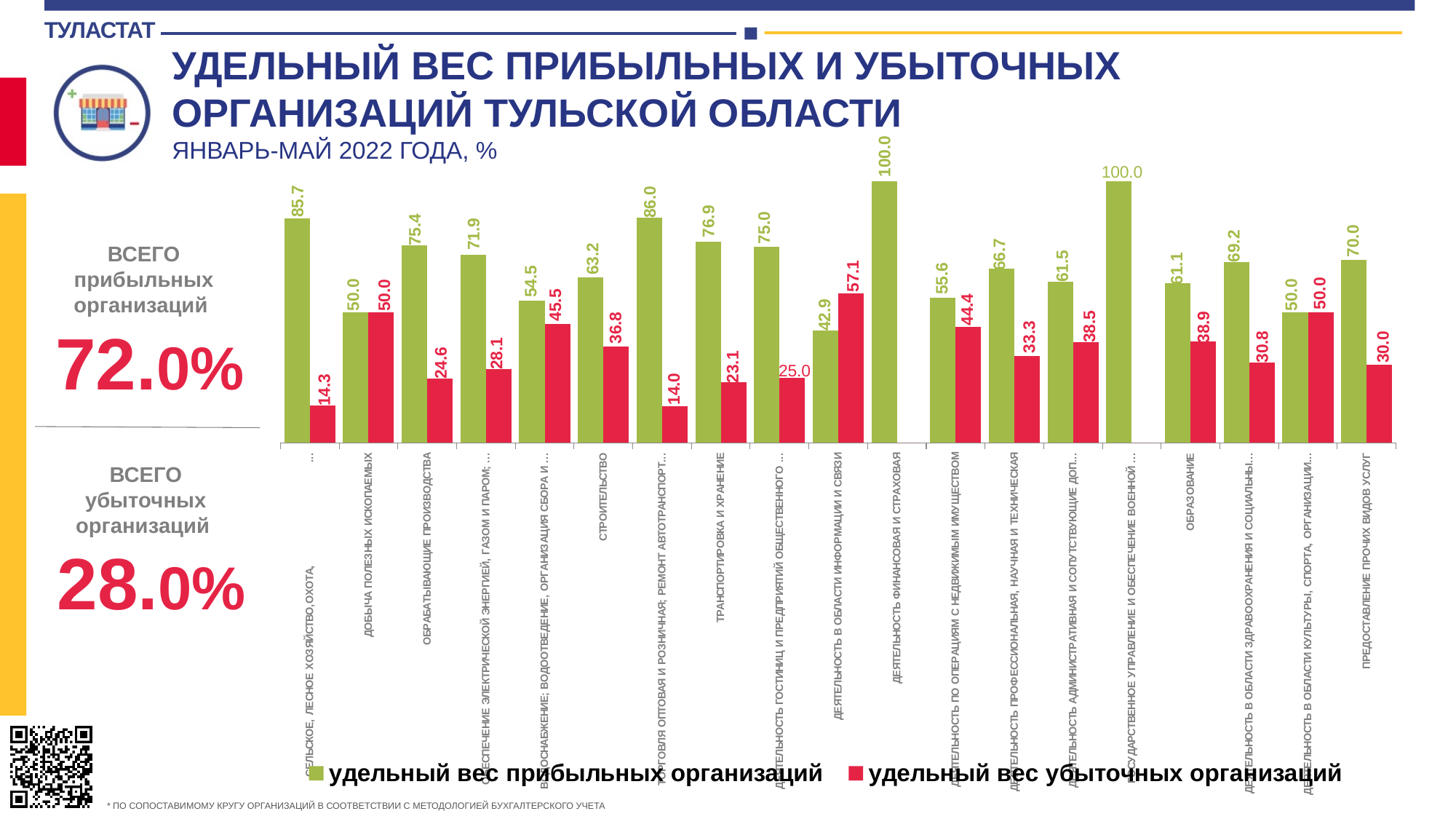
What colour represents the share of profitable organisations in the chart? Green What is the share of profitable organisations for Транспортировка и хранение? 76.9 What is the share of profitable organisations (удельный вес прибыльных организаций) for Строительство? 63.2 What kind of chart is shown on the slide? Bar chart Which category has the highest share of loss-making organisations (red bars)? Деятельность в области информации и связи How many series does the legend list? 2 What is the difference between the profitable and loss-making shares for Строительство? 26.4 What is the share of loss-making organisations (удельный вес убыточных организаций) for Образование? 38.9 Which is larger for Добыча полезных ископаемых: the share of profitable organisations or the share of loss-making organisations? They are equal (50.0 each) What is the share of loss-making organisations for Обрабатывающие производства? 24.6 Which category has the lowest share of profitable organisations (green bars)? Деятельность в области информации и связи Which is larger: the share of profitable organisations for Обрабатывающие производства or for Образование? Обрабатывающие производства